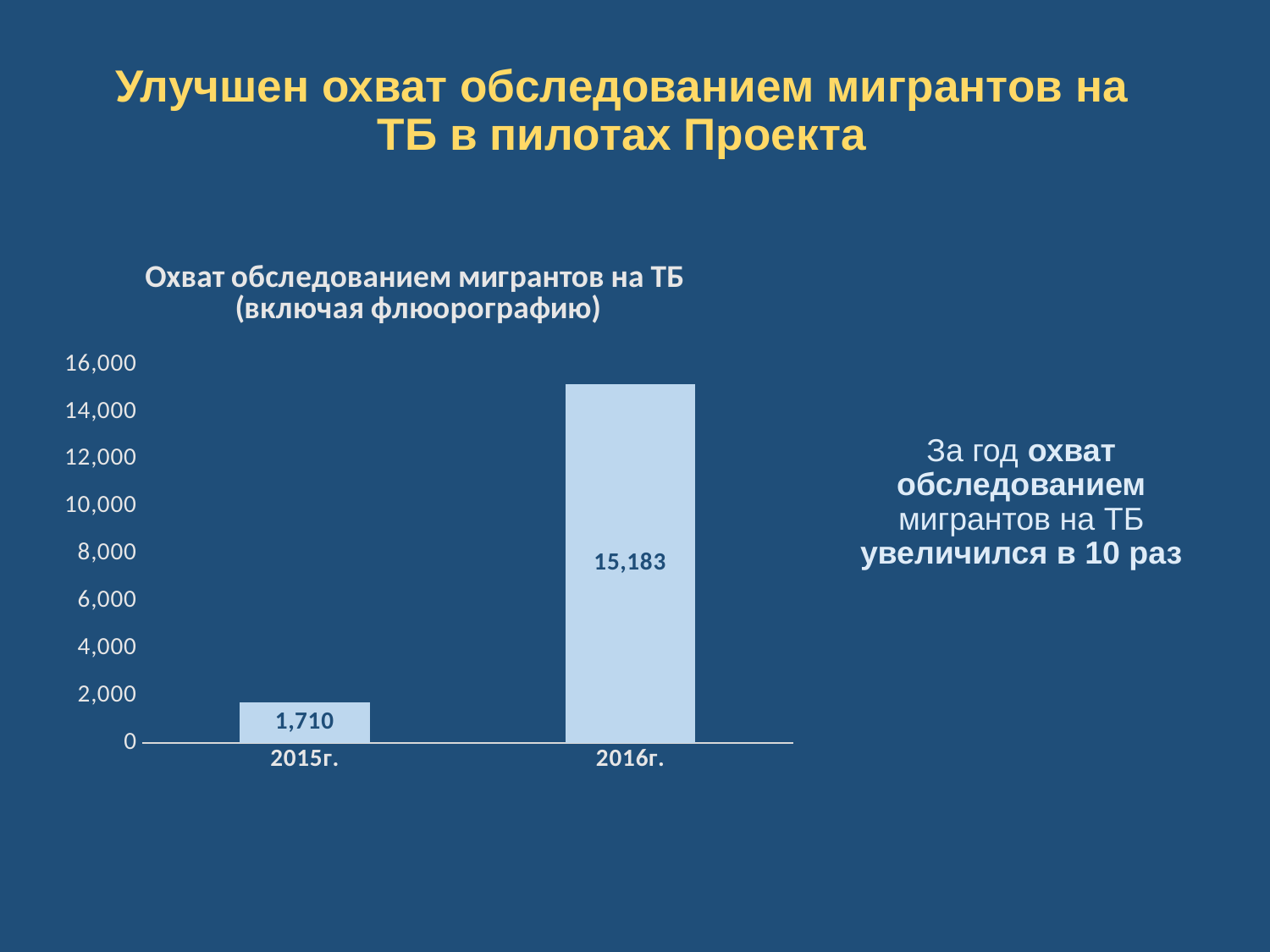
What is the difference between the values for 2016г. and 2015г.? 13,473 What kind of chart is shown on the slide? bar chart What is the value for 2016г.? 15,183 What is the value for 2015г.? 1,710 How many categories are shown on the x axis? 2 Which is larger, the value for 2015г. or the value for 2016г.? 2016г. Do the values rise or fall from 2015г. to 2016г.? rise What is the title of the chart? Охват обследованием мигрантов на ТБ (включая флюорографию) Is the value for 2015г. greater or less than 2,000? less Which year has the highest value? 2016г. Is the value for 2016г. greater or less than 14,000? greater Which year has the lowest value? 2015г.